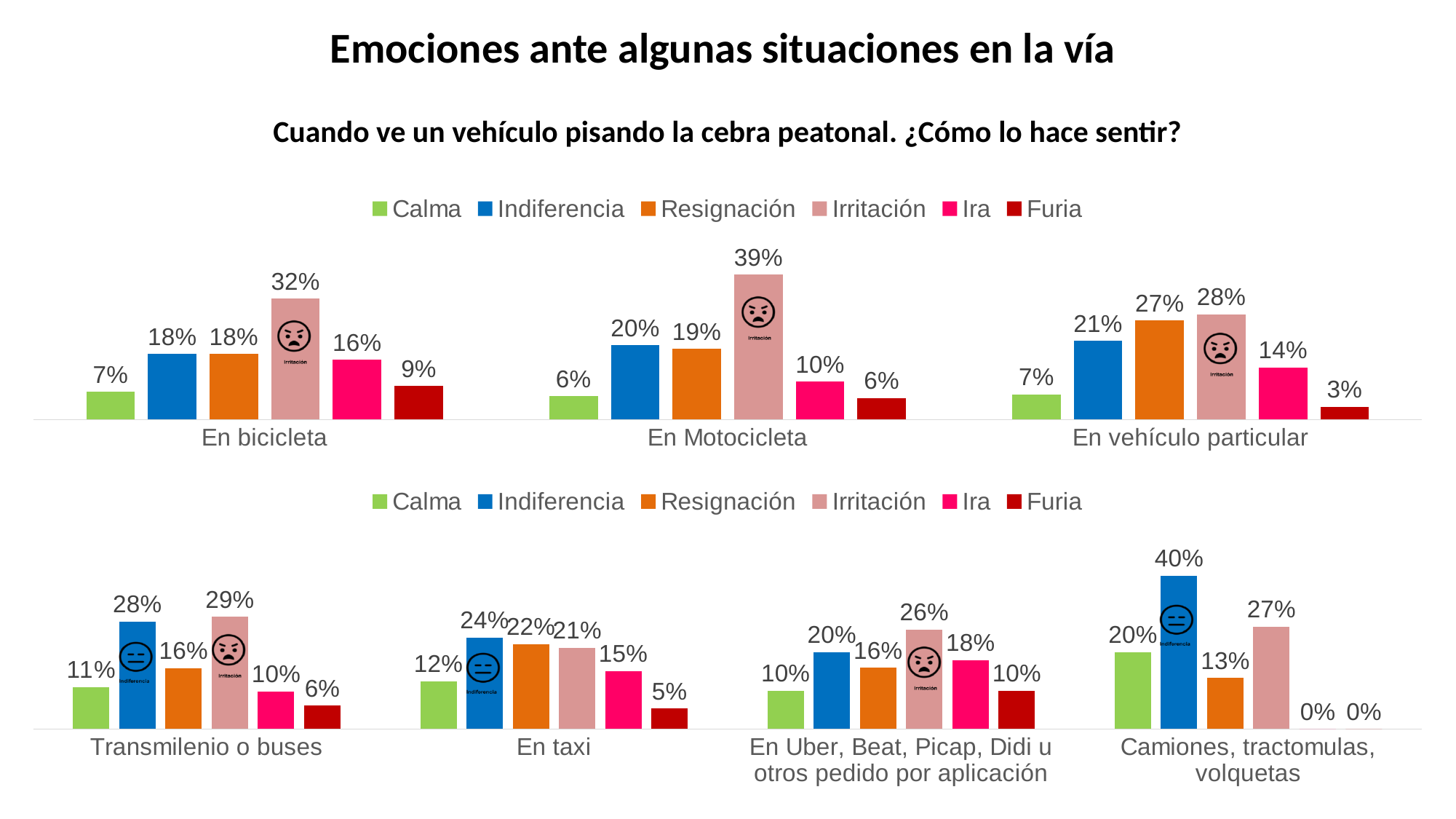
In the top chart, what is the difference between Irritación and Ira in the En Motocicleta category? 29% How many categories are shown on the x axis of the bottom chart? 4 How many series does the legend of the top chart list? 6 In the bottom chart, what is the difference between Irritación and Calma in the Transmilenio o buses category? 18% In the bottom chart, what is the value for Ira in the En taxi category? 15% In the top chart, what is the value for Resignación in the En vehículo particular category? 27% What kind of chart is the top chart? Bar chart In the top chart, which emotion has the lowest value in the En vehículo particular category? Furia In the top chart, what is the value for Irritación in the En Motocicleta category? 39% In the bottom chart, which is larger in the En Uber, Beat, Picap, Didi u otros pedido por aplicación category: Ira or Resignación? Ira In the top chart, which emotion has the highest value in the En bicicleta category? Irritación In the bottom chart, what is the value for Indiferencia in the Camiones, tractomulas, volquetas category? 40%